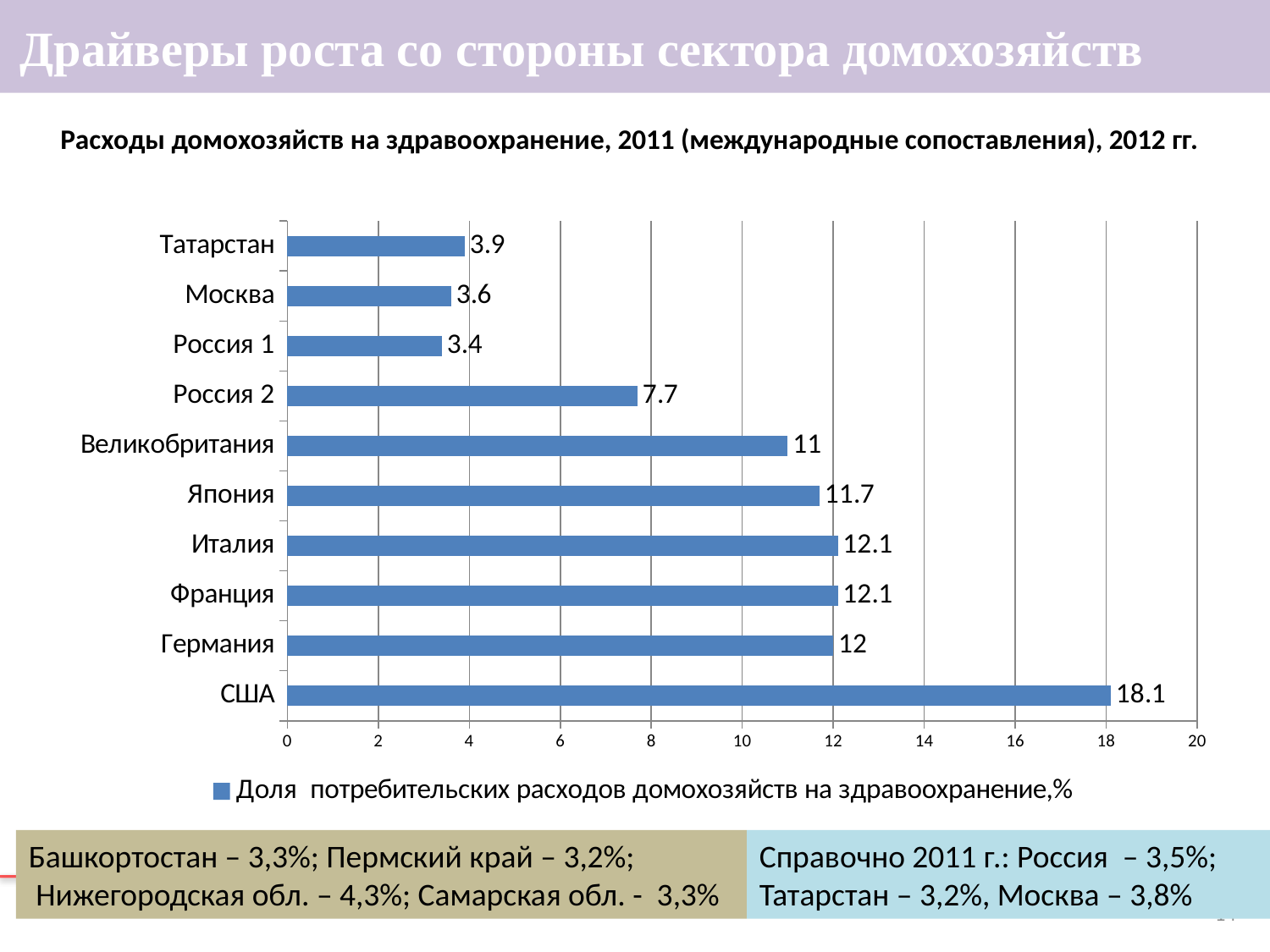
What is the value for Япония (Japan) in the chart? 11.7 What is the value for Россия 2 in the chart? 7.7 Is the value for Япония greater or less than 10? greater What is the value for США (USA) in the chart? 18.1 Which is larger, the value for Великобритания or the value for Россия 2? Великобритания What is the difference between the values for Татарстан and Москва? 0.3 What is the legend entry of the chart? Доля потребительских расходов домохозяйств на здравоохранение,% What is the difference between the values for США and Германия? 6.1 How many categories are shown in the chart? 10 Which category has the highest value in the chart? США What kind of chart is shown on the slide? bar chart Which category has the lowest value in the chart? Россия 1